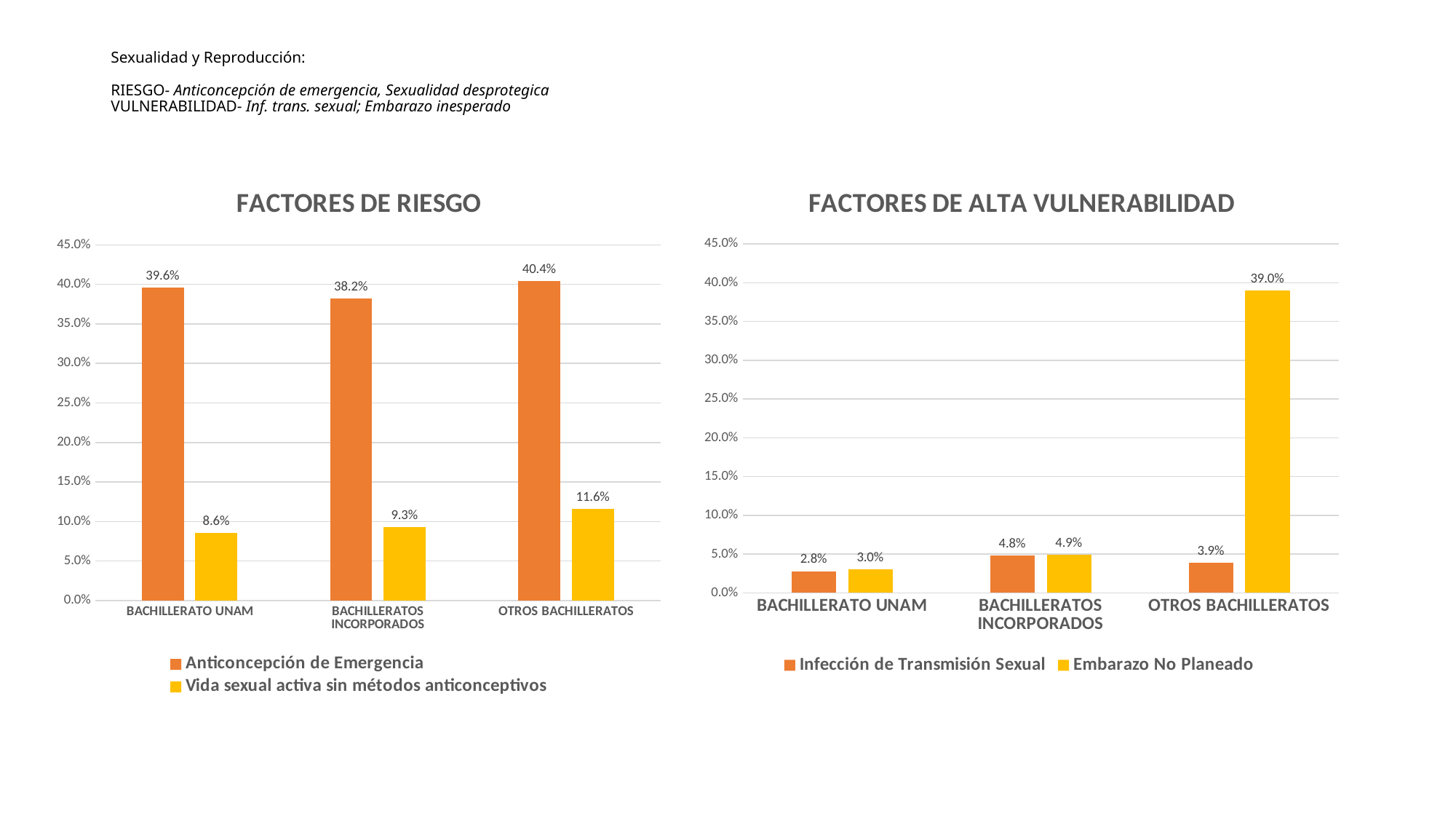
In the FACTORES DE ALTA VULNERABILIDAD chart, how many categories are shown on the x axis? 3 What kind of chart is the FACTORES DE ALTA VULNERABILIDAD chart? Bar chart In the FACTORES DE RIESGO chart, which category has the highest value for Anticoncepción de Emergencia? OTROS BACHILLERATOS In the FACTORES DE RIESGO chart, what is the value of Vida sexual activa sin métodos anticonceptivos for OTROS BACHILLERATOS? 11.6% In the FACTORES DE RIESGO chart, what is the value of Anticoncepción de Emergencia for BACHILLERATO UNAM? 39.6% In the FACTORES DE ALTA VULNERABILIDAD chart, which category has the highest value for Infección de Transmisión Sexual? BACHILLERATOS INCORPORADOS In the FACTORES DE ALTA VULNERABILIDAD chart, what is the difference between Embarazo No Planeado and Infección de Transmisión Sexual for OTROS BACHILLERATOS? 35.1% In the FACTORES DE ALTA VULNERABILIDAD chart, what is the value of Infección de Transmisión Sexual for BACHILLERATO UNAM? 2.8% In the FACTORES DE RIESGO chart, how many series does the legend list? 2 In the FACTORES DE ALTA VULNERABILIDAD chart, what is the value of Embarazo No Planeado for OTROS BACHILLERATOS? 39.0% In the FACTORES DE RIESGO chart, which category has the lowest value for Vida sexual activa sin métodos anticonceptivos? BACHILLERATO UNAM In the FACTORES DE RIESGO chart, what is the difference between Anticoncepción de Emergencia and Vida sexual activa sin métodos anticonceptivos for BACHILLERATOS INCORPORADOS? 28.9%